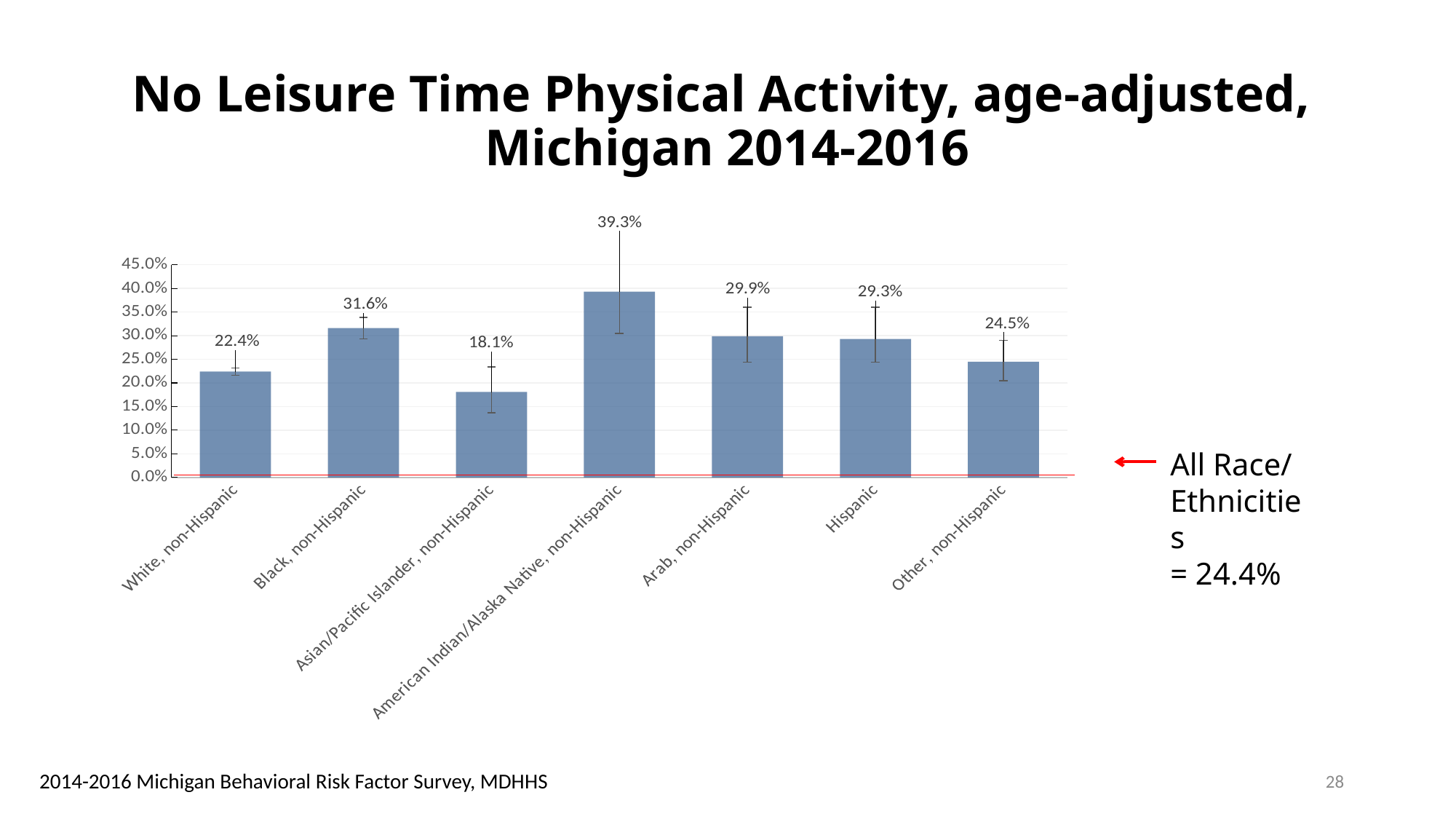
Is the value for Hispanic greater or less than 25.0%? greater What is the value for Other, non-Hispanic? 24.5% What is the value for American Indian/Alaska Native, non-Hispanic? 39.3% Which is larger, the value for Arab, non-Hispanic or the value for Other, non-Hispanic? Arab, non-Hispanic What value does the red line labelled All Race/Ethnicities represent? 24.4% What is the title of the chart? No Leisure Time Physical Activity, age-adjusted, Michigan 2014-2016 What kind of chart is shown on the slide? bar chart What is the value for Black, non-Hispanic? 31.6% How many categories are shown on the x axis? 7 Which category has the highest value? American Indian/Alaska Native, non-Hispanic What is the difference between the values for Black, non-Hispanic and White, non-Hispanic? 9.2% Which category has the lowest value? Asian/Pacific Islander, non-Hispanic